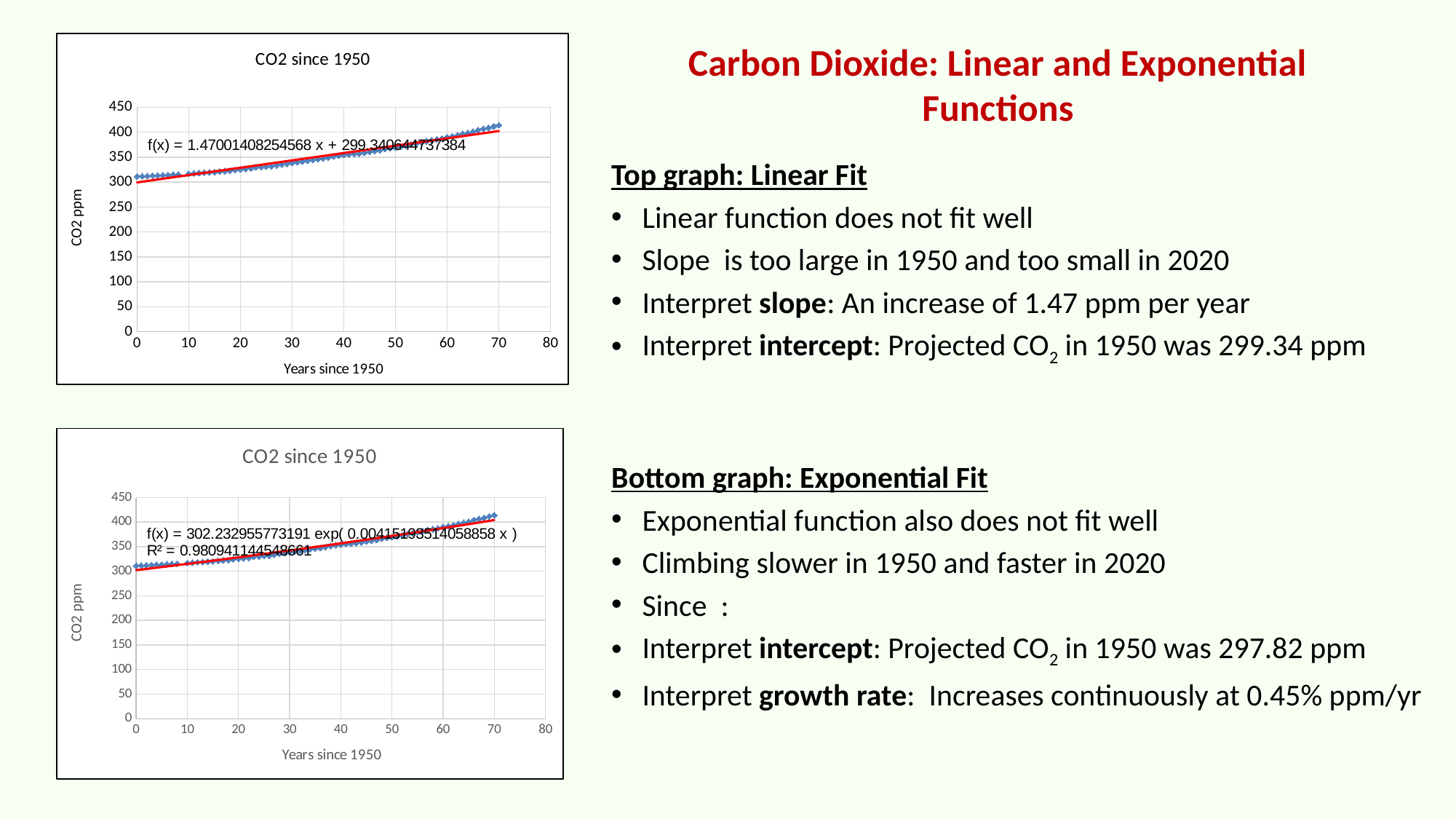
What is the x-axis title of the bottom chart? Years since 1950 In the bottom chart, is the CO2 ppm value at 70 years since 1950 greater or less than 400? greater In the bottom chart, do the plotted values rise or fall along the x axis? rise What kind of chart is the top chart on the slide? scatter chart What is the intercept shown in the fitted linear equation on the top chart? 299.340644737384 In the top chart, is the CO2 ppm value at 0 years since 1950 greater or less than 350? less In the bottom chart, is the CO2 ppm value at 30 years since 1950 greater or less than 350? less In the top chart, do the CO2 ppm values rise or fall as years since 1950 increase? rise What is the title of the top chart? CO2 since 1950 What is the slope shown in the fitted linear equation on the top chart? 1.47001408254568 In the top chart, which has the higher CO2 ppm value: 10 years since 1950 or 60 years since 1950? 60 years since 1950